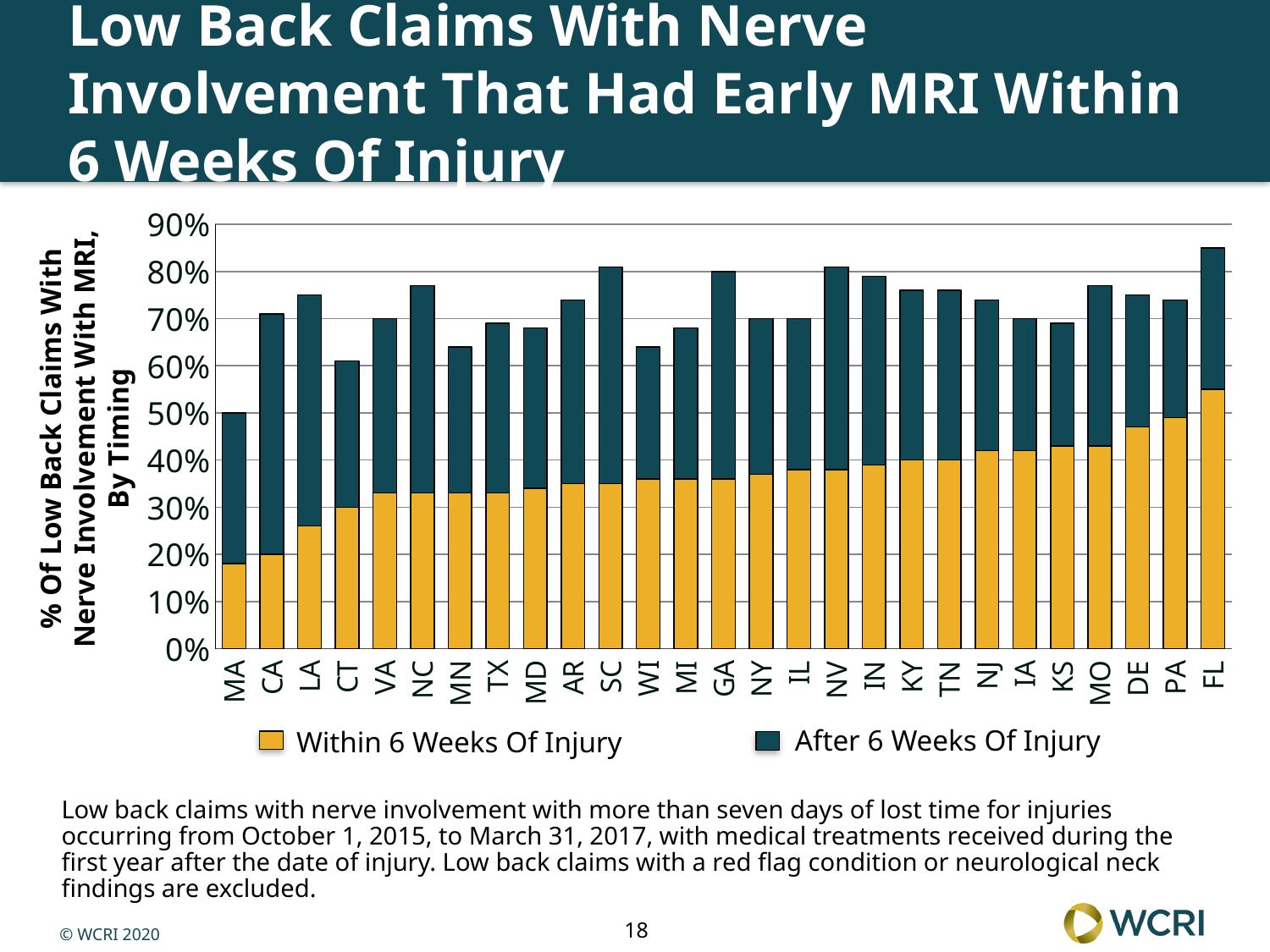
Is the total stacked bar for CT greater or less than 70%? less Which state has the lowest total stacked bar? MA Which state has the lowest value for Within 6 Weeks Of Injury? MA Which state has the highest value for Within 6 Weeks Of Injury? FL How many states are shown along the x axis of the chart? 27 Which is larger for Within 6 Weeks Of Injury, CA or KS? KS Which colour represents After 6 Weeks Of Injury in the chart? Dark teal Is the value for LA Within 6 Weeks Of Injury greater or less than 30%? less What kind of chart is shown on the slide? Stacked bar chart How many series does the chart's legend list? 2 Do the Within 6 Weeks Of Injury values generally rise or fall from left to right along the x axis? rise Is the value for FL Within 6 Weeks Of Injury greater or less than 50%? greater